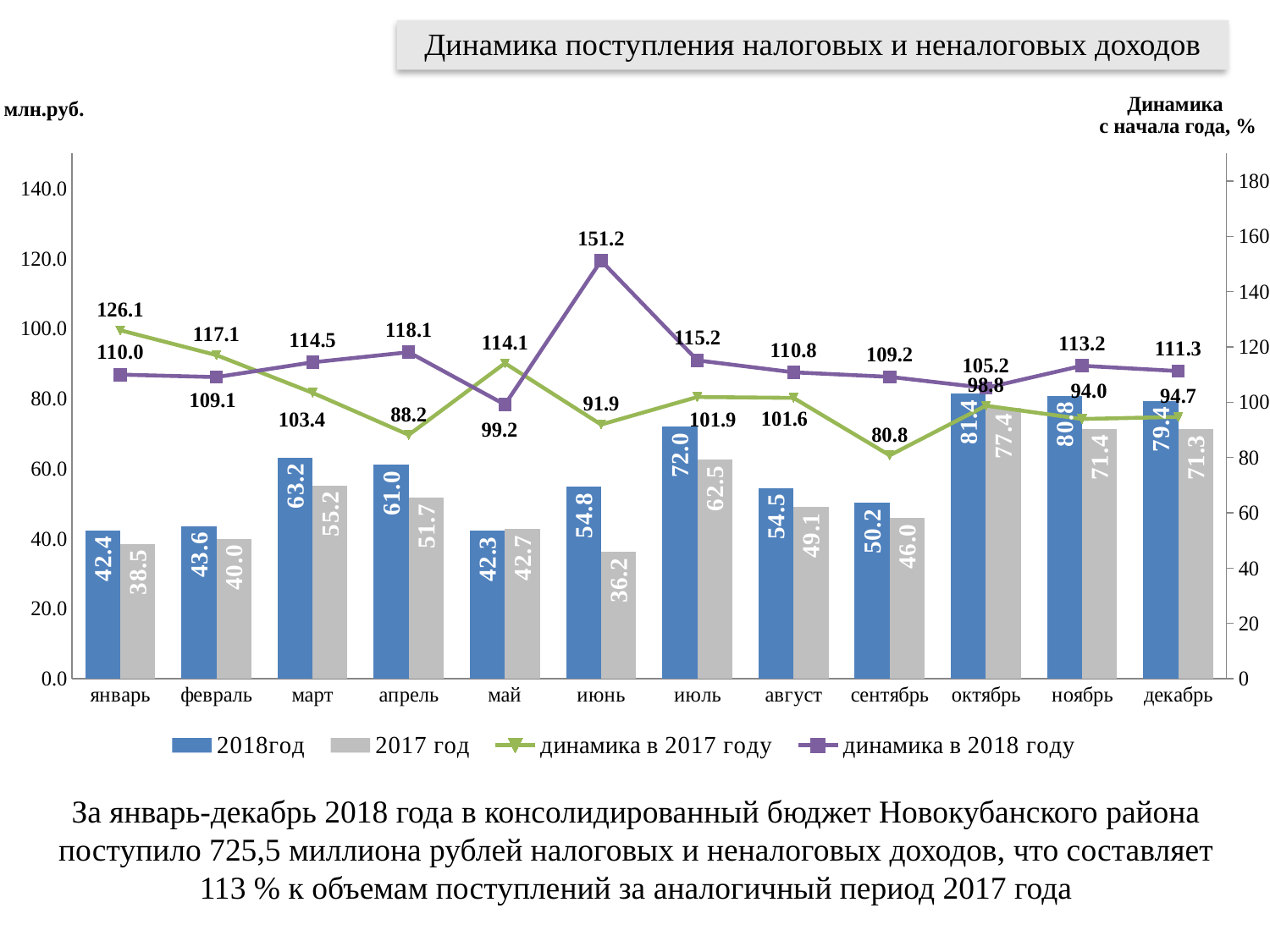
What is the value of динамика в 2018 году in июнь? 151.2 In which month is the 2017 год bar lowest? июнь How many series does the legend list? 4 What kind of chart is this? Combined bar and line chart What is the title of the chart? Динамика поступления налоговых и неналоговых доходов What is the value of динамика в 2017 году in сентябрь? 80.8 What is the value for 2018 год in июль? 72.0 What is the value for 2017 год in октябрь? 77.4 In which month is the 2018 год bar highest? октябрь Which is larger in май: the 2018 год value or the 2017 год value? 2017 год What is the difference between the 2018 год and 2017 год values in июль? 9.5 How many months are shown on the x axis? 12